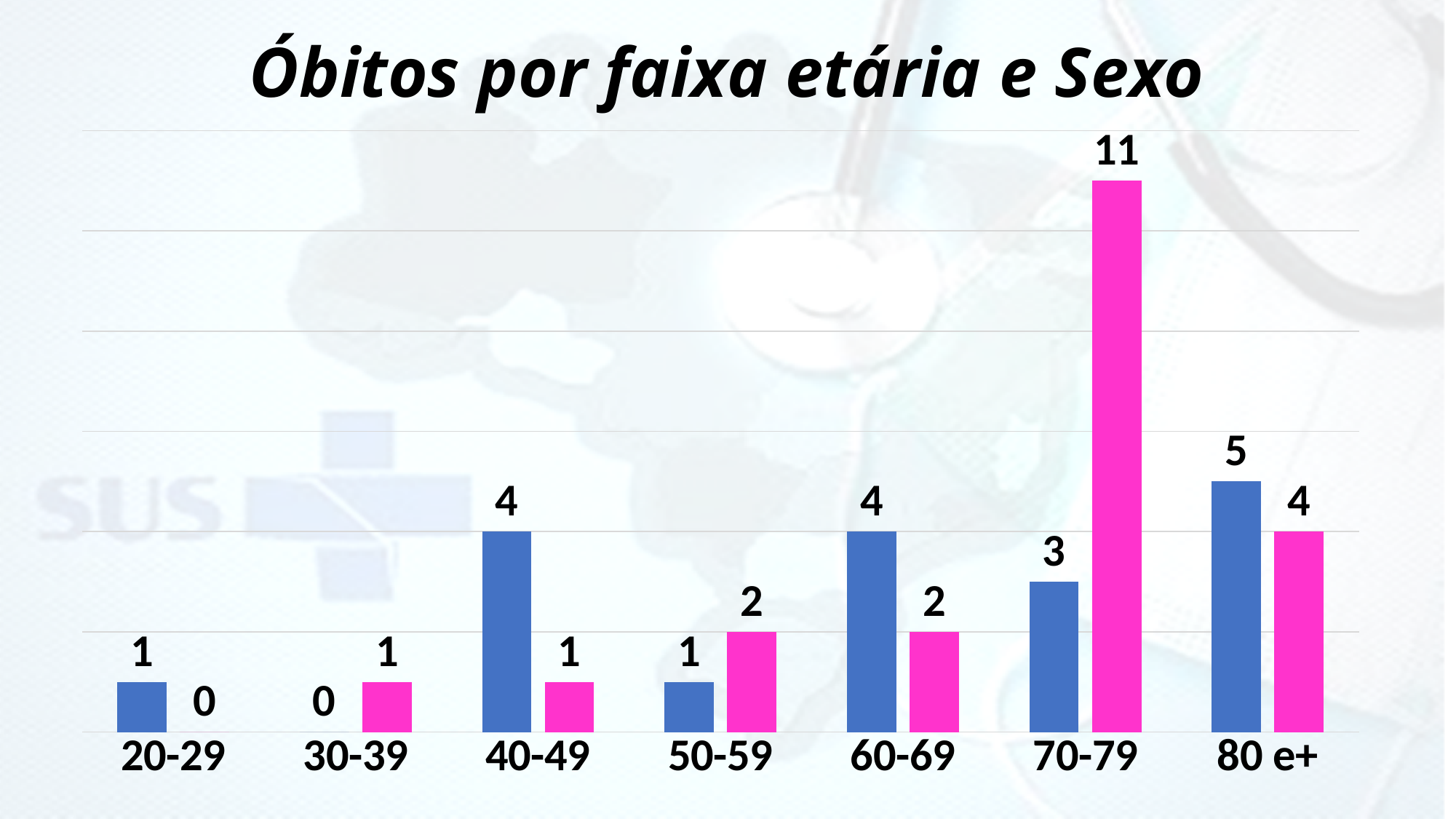
What is the value of the blue bar for the 80 e+ age group? 5 Which age group has the lowest blue bar? 30-39 How many age groups are shown on the x axis? 7 Which age group has the highest blue bar? 80 e+ What is the title of the chart? Óbitos por faixa etária e Sexo What kind of chart is shown on the slide? bar chart Which age group has the highest pink bar? 70-79 What is the value of the pink bar for the 70-79 age group? 11 What is the value of the blue bar for the 40-49 age group? 4 What is the value of the pink bar for the 20-29 age group? 0 For the 80 e+ age group, which is larger, the blue bar or the pink bar? the blue bar What is the difference between the pink bar and the blue bar for the 70-79 age group? 8